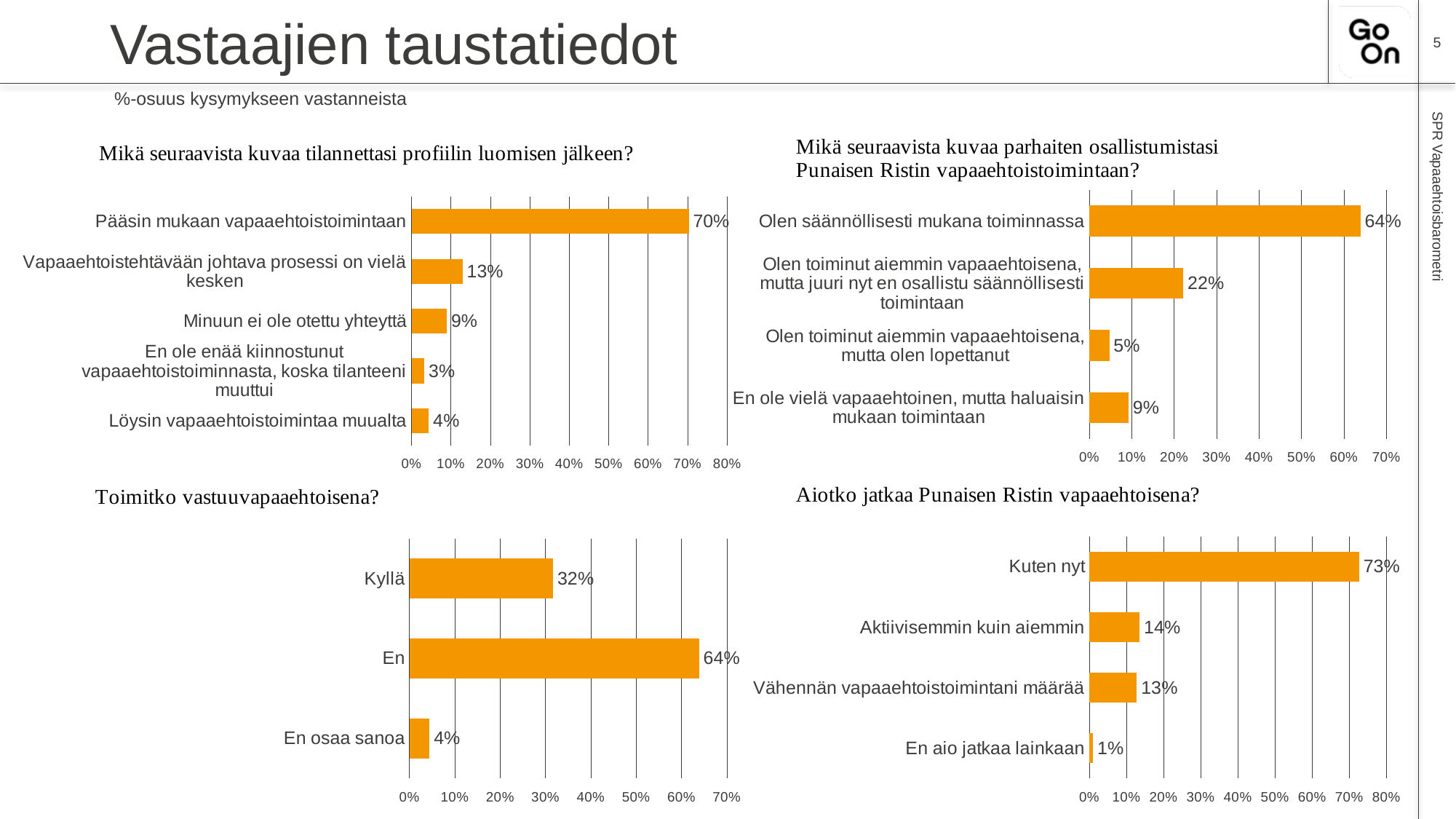
In the chart 'Mikä seuraavista kuvaa tilannettasi profiilin luomisen jälkeen?', which category has the lowest value? En ole enää kiinnostunut vapaaehtoistoiminnasta, koska tilanteeni muuttui In the chart 'Aiotko jatkaa Punaisen Ristin vapaaehtoisena?', how many categories are shown? 4 In the chart 'Mikä seuraavista kuvaa tilannettasi profiilin luomisen jälkeen?', what is the value for 'Pääsin mukaan vapaaehtoistoimintaan'? 70% In the chart 'Mikä seuraavista kuvaa tilannettasi profiilin luomisen jälkeen?', how many categories are shown? 5 In the chart 'Toimitko vastuuvapaaehtoisena?', what is the difference between 'En' and 'Kyllä'? 32% In the chart 'Aiotko jatkaa Punaisen Ristin vapaaehtoisena?', what is the value for 'En aio jatkaa lainkaan'? 1% In the chart 'Toimitko vastuuvapaaehtoisena?', what is the value for 'Kyllä'? 32% In the chart 'Mikä seuraavista kuvaa parhaiten osallistumistasi Punaisen Ristin vapaaehtoistoimintaan?', what is the difference between 'Olen säännöllisesti mukana toiminnassa' and 'Olen toiminut aiemmin vapaaehtoisena, mutta juuri nyt en osallistu säännöllisesti toimintaan'? 42% In the chart 'Mikä seuraavista kuvaa parhaiten osallistumistasi Punaisen Ristin vapaaehtoistoimintaan?', which category has the highest value? Olen säännöllisesti mukana toiminnassa In the chart 'Toimitko vastuuvapaaehtoisena?', which is larger, 'Kyllä' or 'En'? En In the chart 'Mikä seuraavista kuvaa parhaiten osallistumistasi Punaisen Ristin vapaaehtoistoimintaan?', what is the value for 'Olen toiminut aiemmin vapaaehtoisena, mutta olen lopettanut'? 5% What kind of chart is 'Aiotko jatkaa Punaisen Ristin vapaaehtoisena?'? Bar chart